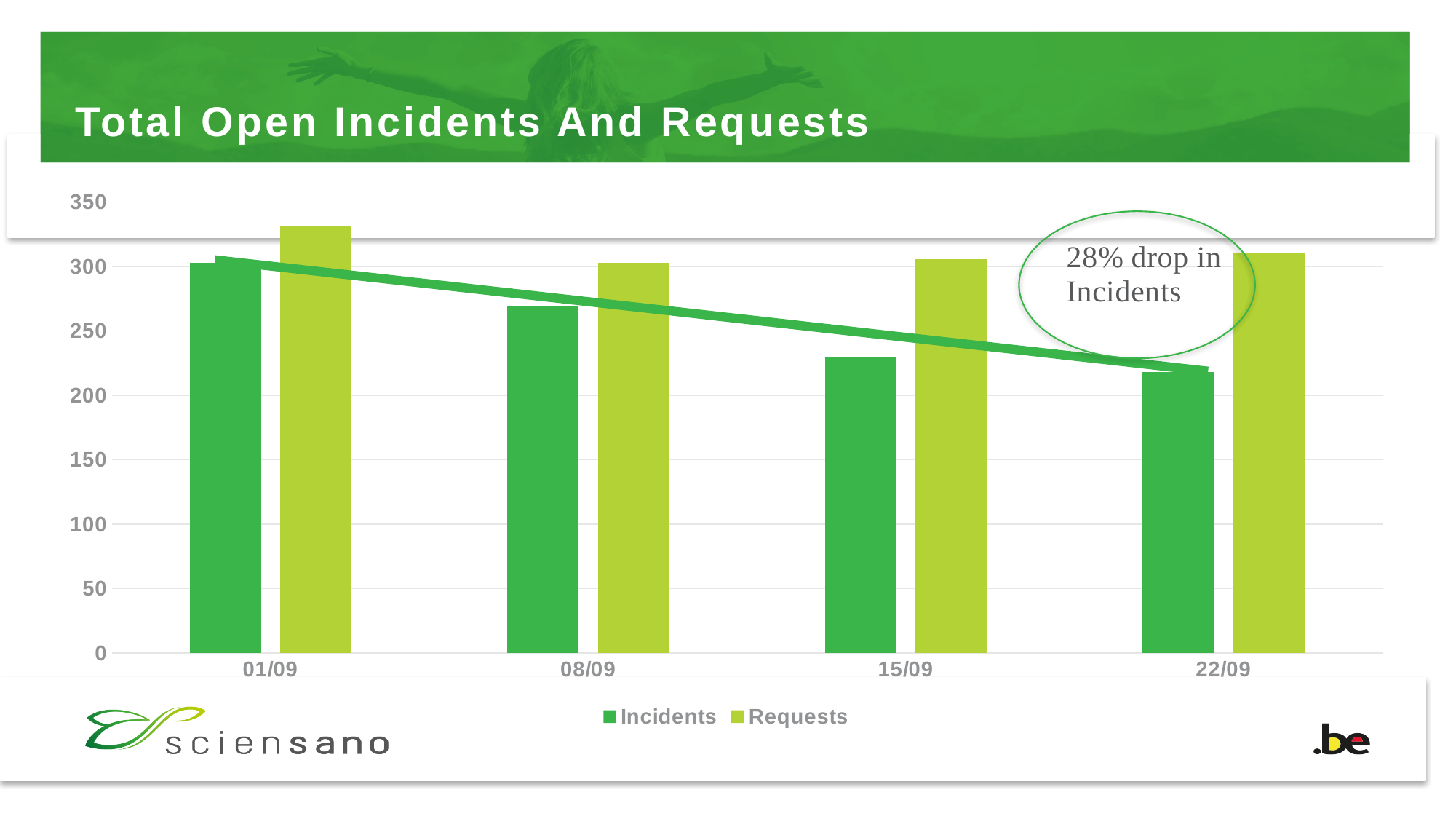
On which date is the Requests bar highest? 01/09 On which date is the Incidents bar highest? 01/09 How many series does the chart's legend list? 2 On 22/09, which is larger: Incidents or Requests? Requests Is the Requests value for 01/09 greater or less than 300? greater How many dates are shown on the x axis of the chart? 4 What kind of chart is shown on the slide? Bar chart Is the Incidents value for 22/09 greater or less than 250? less On which date is the Incidents bar lowest? 22/09 What does the circled annotation on the chart say? 28% drop in Incidents Is the Incidents value for 15/09 greater or less than 250? less Do the Incidents values rise or fall from 01/09 to 22/09? Fall